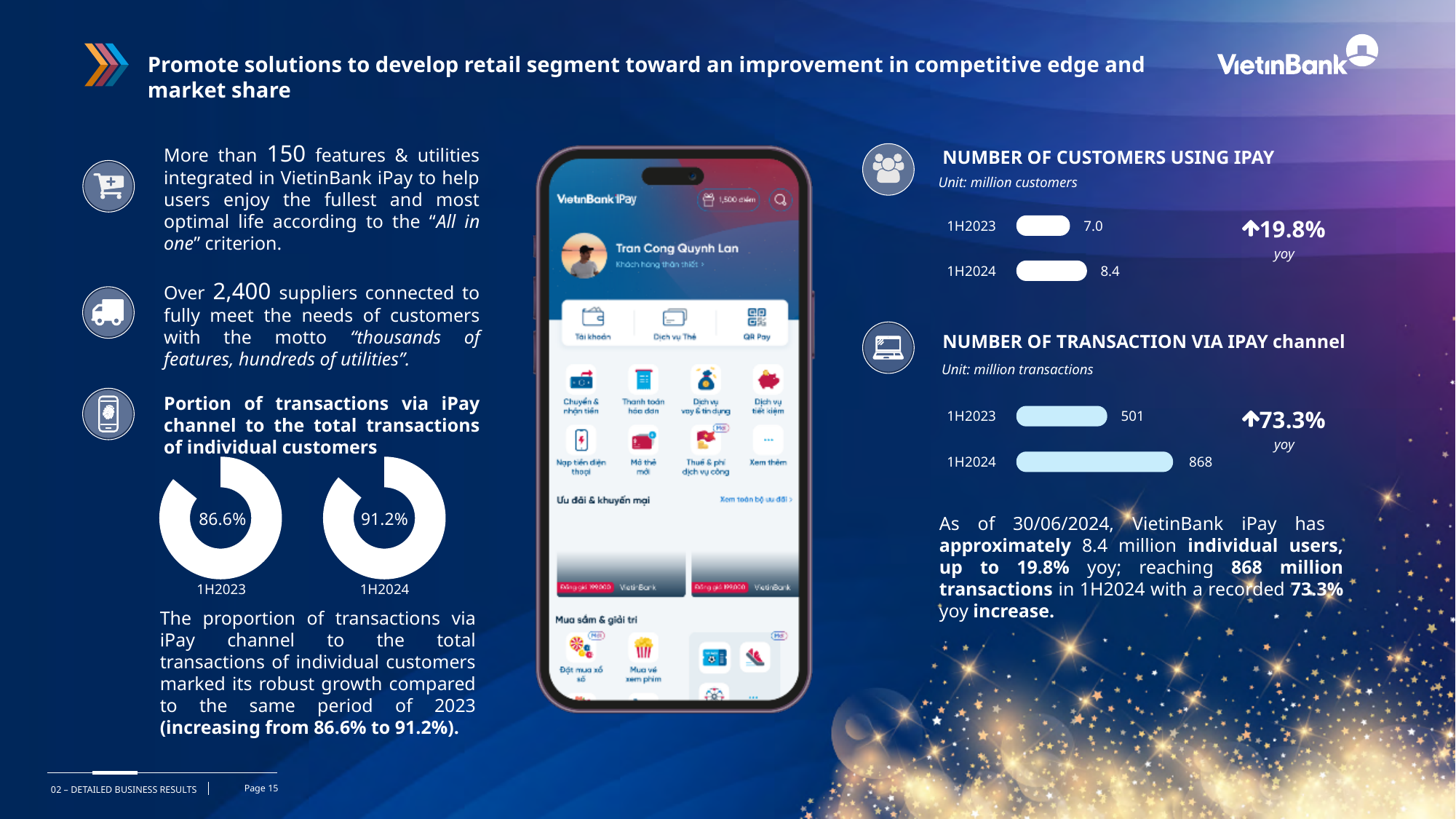
In the 'NUMBER OF CUSTOMERS USING IPAY' chart, what is the value for 1H2023? 7.0 In the 'NUMBER OF TRANSACTION VIA IPAY channel' chart, which period has the higher value? 1H2024 In the 'NUMBER OF TRANSACTION VIA IPAY channel' chart, what is the difference between the 1H2024 and 1H2023 values? 367 In the 'NUMBER OF CUSTOMERS USING IPAY' chart, what is the difference between the 1H2024 and 1H2023 values? 1.4 In the 'NUMBER OF CUSTOMERS USING IPAY' chart, what is the value for 1H2024? 8.4 What kind of chart is used for 'NUMBER OF TRANSACTION VIA IPAY channel'? Bar chart In the donut charts showing the portion of transactions via iPay channel, what is the value for 1H2023? 86.6% In the donut charts showing the portion of transactions via iPay channel, what is the value for 1H2024? 91.2% What unit is stated for the 'NUMBER OF CUSTOMERS USING IPAY' chart? million customers In the 'NUMBER OF TRANSACTION VIA IPAY channel' chart, what is the value for 1H2023? 501 In the 'NUMBER OF TRANSACTION VIA IPAY channel' chart, what is the value for 1H2024? 868 In the 'NUMBER OF CUSTOMERS USING IPAY' chart, which period has the lower value? 1H2023